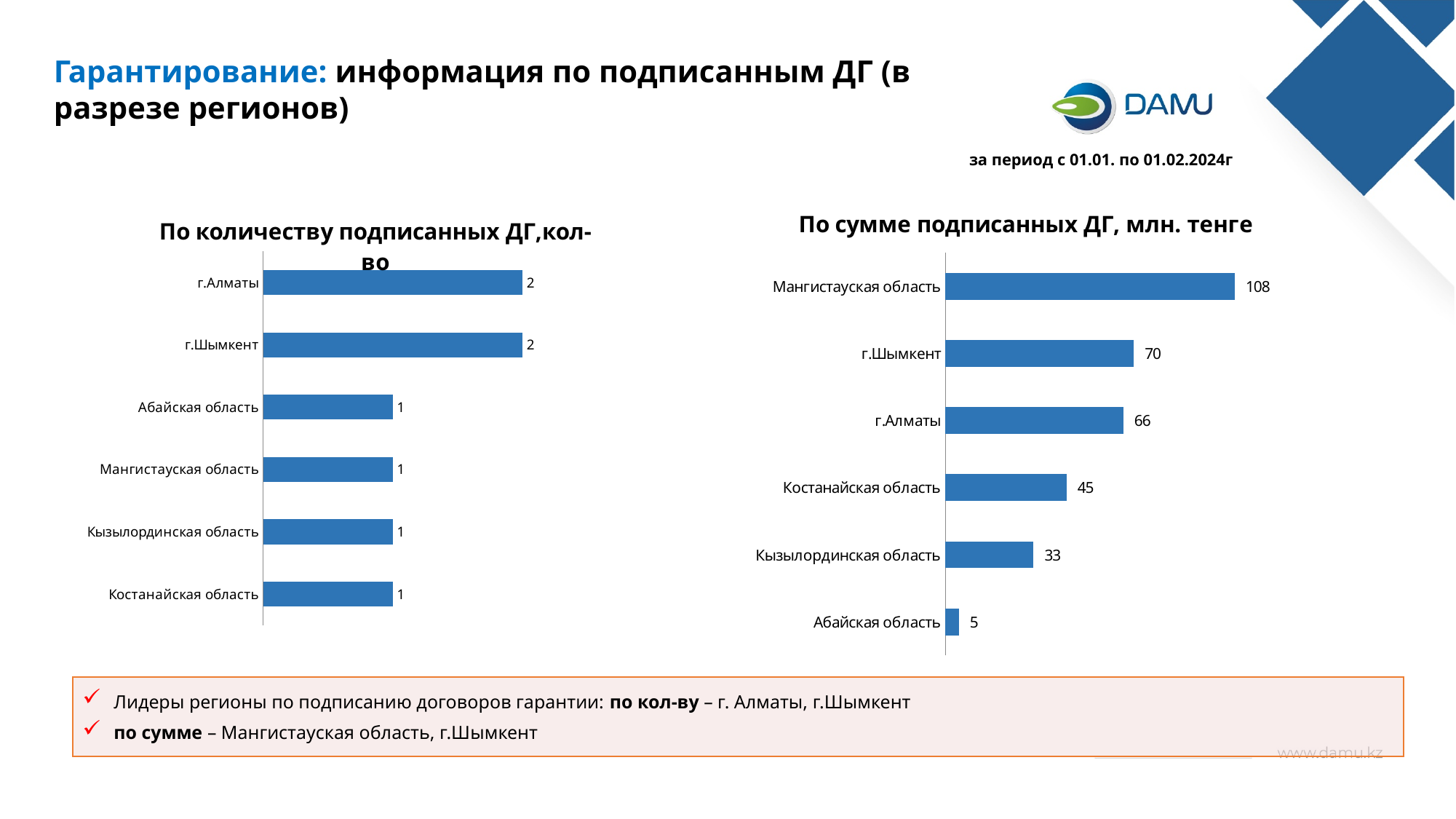
In the chart 'По сумме подписанных ДГ, млн. тенге', what is the difference between г.Шымкент and г.Алматы? 4 What is the title of the chart on the right side of the slide? По сумме подписанных ДГ, млн. тенге How many regions are shown in the chart 'По количеству подписанных ДГ,кол-во'? 6 In the chart 'По сумме подписанных ДГ, млн. тенге', what is the value for Костанайская область? 45 In the chart 'По сумме подписанных ДГ, млн. тенге', what is the difference between Мангистауская область and Кызылординская область? 75 In the chart 'По сумме подписанных ДГ, млн. тенге', which region has the highest value? Мангистауская область In the chart 'По количеству подписанных ДГ,кол-во', what is the value for Абайская область? 1 What type of chart is 'По сумме подписанных ДГ, млн. тенге'? Bar chart In the chart 'По сумме подписанных ДГ, млн. тенге', what is the value for Мангистауская область? 108 In the chart 'По сумме подписанных ДГ, млн. тенге', which is larger: Костанайская область or Кызылординская область? Костанайская область In the chart 'По сумме подписанных ДГ, млн. тенге', which region has the lowest value? Абайская область In the chart 'По количеству подписанных ДГ,кол-во', which is larger: г.Шымкент or Мангистауская область? г.Шымкент